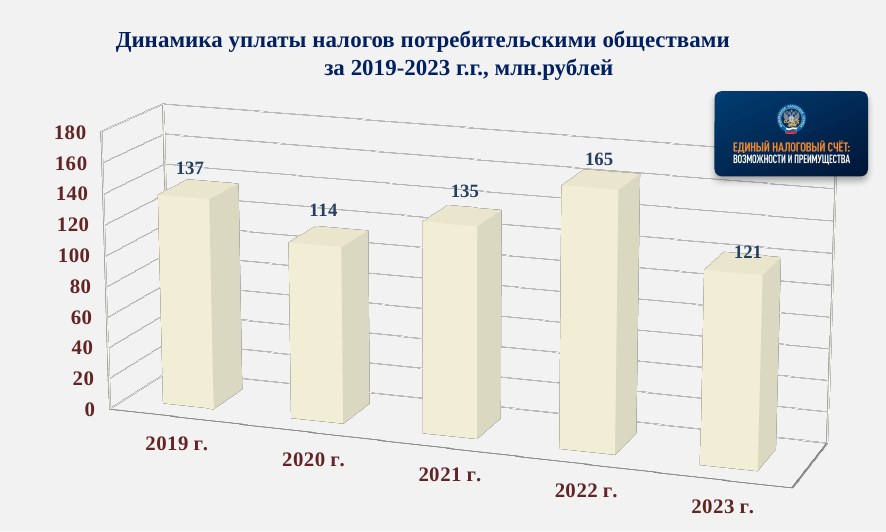
What is the value for 2019 г.? 137 What is the title of the chart? Динамика уплаты налогов потребительскими обществами за 2019-2023 г.г., млн.рублей What is the value for 2023 г.? 121 How many years are shown on the chart? 5 What is the value for 2022 г.? 165 Which is larger, the value for 2021 г. or the value for 2023 г.? 2021 г. What kind of chart is this? bar chart What is the difference between the values for 2022 г. and 2020 г.? 51 Is the value for 2022 г. greater or less than 160? greater Which year has the lowest value? 2020 г. What is the difference between the values for 2019 г. and 2021 г.? 2 Which year has the highest value? 2022 г.